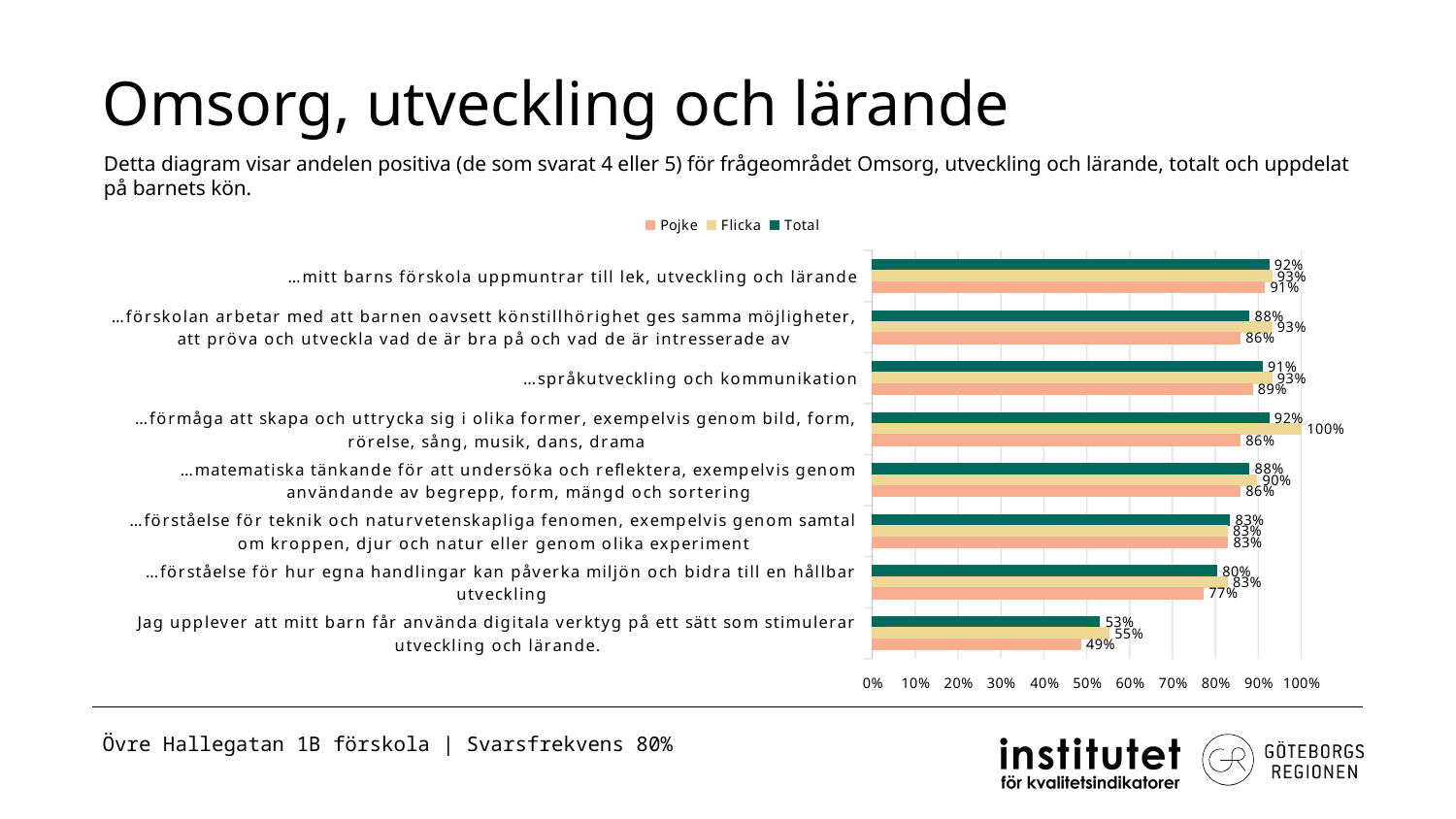
What is the difference between the Flicka and Pojke values for "…förskolan arbetar med att barnen oavsett könstillhörighet ges samma möjligheter, att pröva och utveckla vad de är bra på och vad de är intresserade av"? 7% Which category has the lowest Total value? Jag upplever att mitt barn får använda digitala verktyg på ett sätt som stimulerar utveckling och lärande. Which series has the highest value for "…förmåga att skapa och uttrycka sig i olika former, exempelvis genom bild, form, rörelse, sång, musik, dans, drama"? Flicka How many categories (statements) are plotted in the chart? 8 What is the Flicka value for "…förmåga att skapa och uttrycka sig i olika former, exempelvis genom bild, form, rörelse, sång, musik, dans, drama"? 100% Which series is shown in dark green in the legend? Total What is the Pojke value for "Jag upplever att mitt barn får använda digitala verktyg på ett sätt som stimulerar utveckling och lärande."? 49% What is the Total value for "…språkutveckling och kommunikation"? 91% Is the Total value for "Jag upplever att mitt barn får använda digitala verktyg på ett sätt som stimulerar utveckling och lärande." greater or less than 60%? less What kind of chart is shown on the slide? bar chart How many series does the legend list? 3 For "…förståelse för hur egna handlingar kan påverka miljön och bidra till en hållbar utveckling", which is larger: the Flicka value or the Pojke value? Flicka